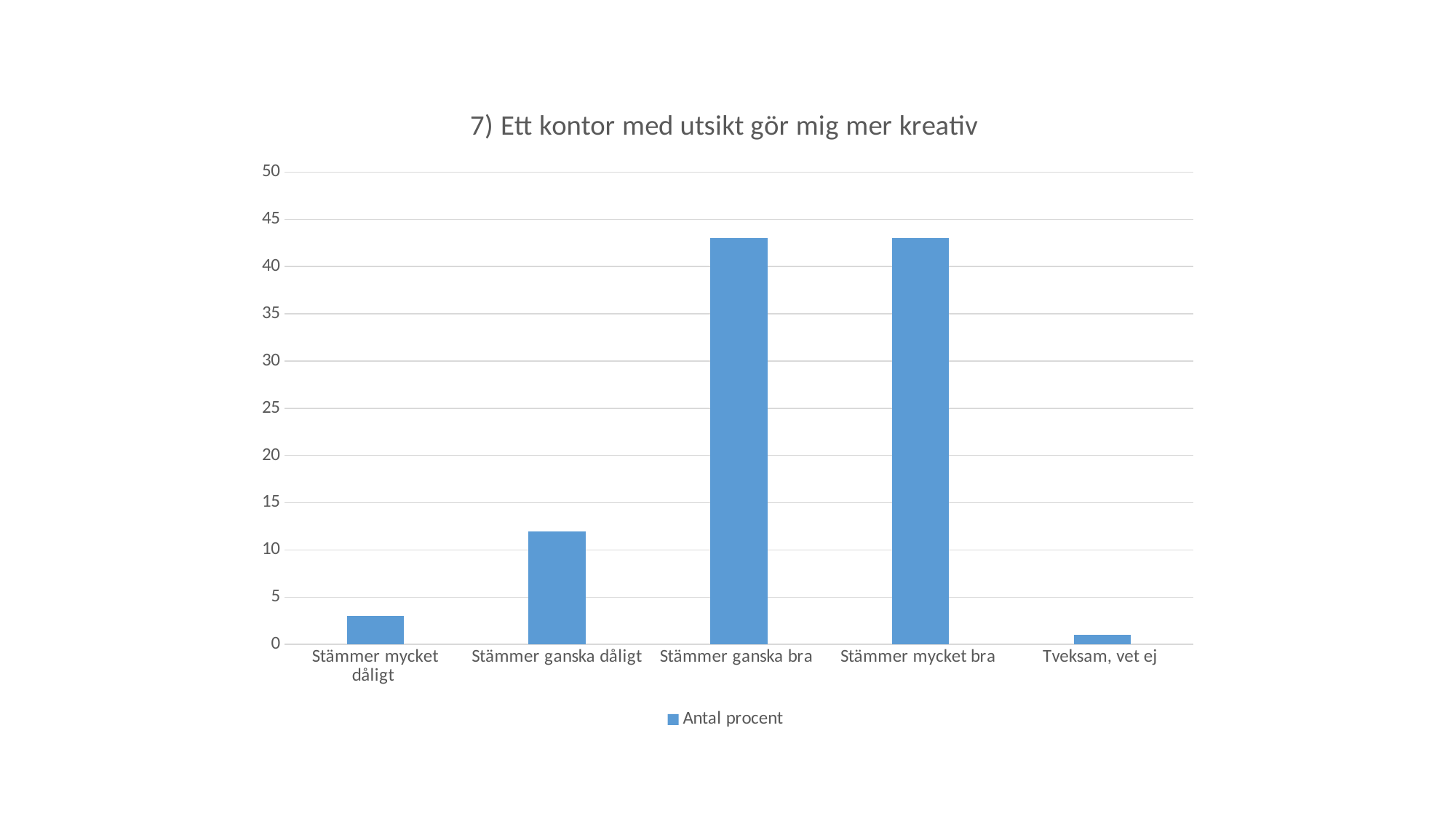
What is the title of the chart? 7) Ett kontor med utsikt gör mig mer kreativ Is the value for Stämmer mycket dåligt greater or less than 5? less Is the value for Stämmer mycket bra greater or less than 45? less Which is larger, the value for Stämmer ganska bra or the value for Stämmer ganska dåligt? Stämmer ganska bra Is the value for Stämmer ganska dåligt greater or less than 10? greater What kind of chart is shown on the slide? bar chart How many categories are shown on the x axis of the chart? 5 Which is larger, the value for Stämmer ganska dåligt or the value for Stämmer mycket dåligt? Stämmer ganska dåligt How many series does the legend list? 1 Which category has the lowest value? Tveksam, vet ej What is the name of the series shown in the legend? Antal procent